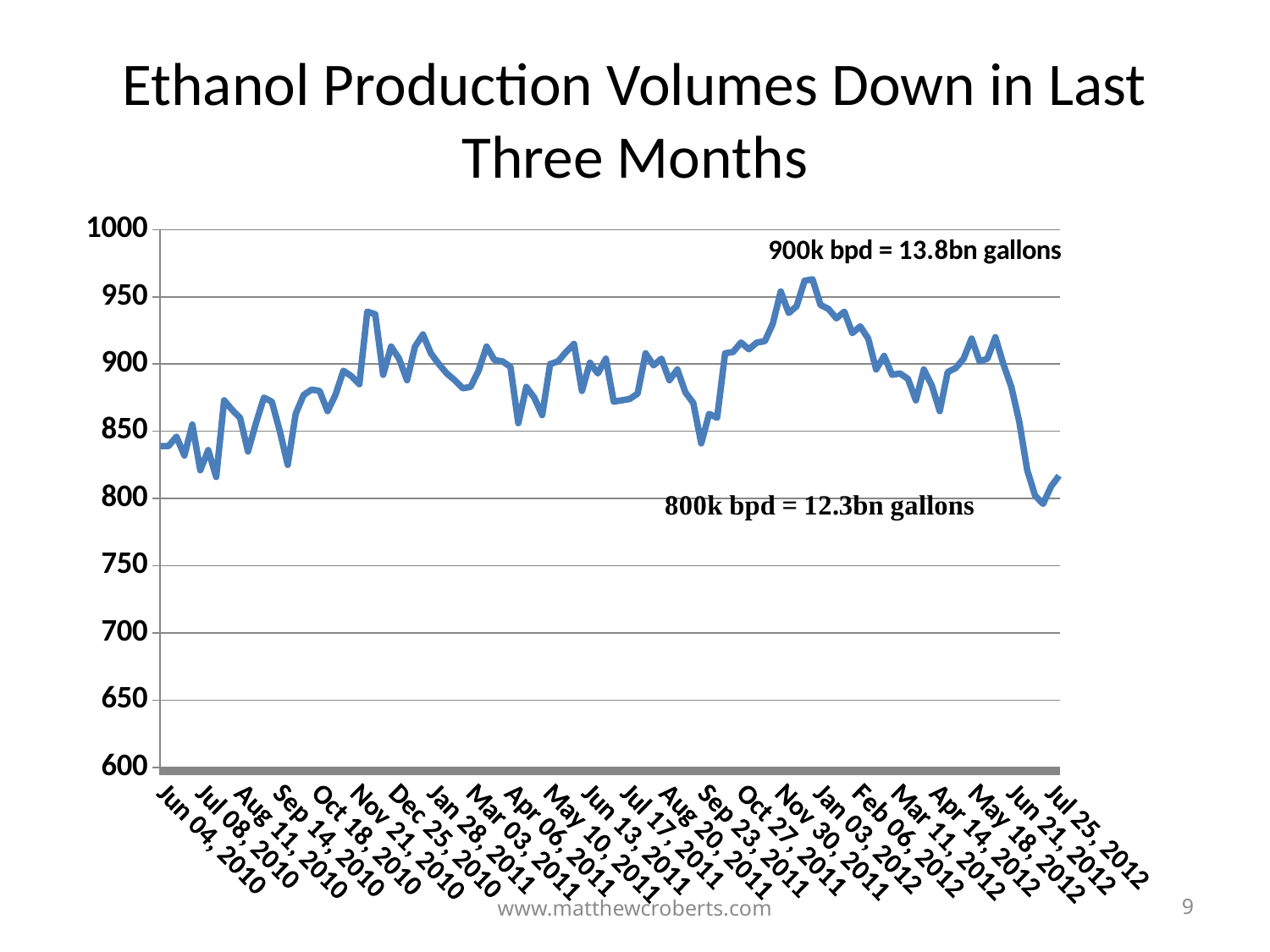
Is the lowest value reached by the line greater or less than 850? less Is the value at Jul 25, 2012 greater or less than 850? less According to the annotation on the chart, how many billion gallons does 900k bpd equal? 13.8bn gallons Do the values rise or fall over the last three months shown on the chart (from around May 2012 to Jul 25, 2012)? fall Do the values generally rise or fall from Jun 04, 2010 to the peak near the end of 2011? rise Is the value at Jun 04, 2010 greater or less than 900? less What is the title of the slide's chart? Ethanol Production Volumes Down in Last Three Months What is the lowest value shown on the vertical axis? 600 What kind of chart is shown on the slide? line chart